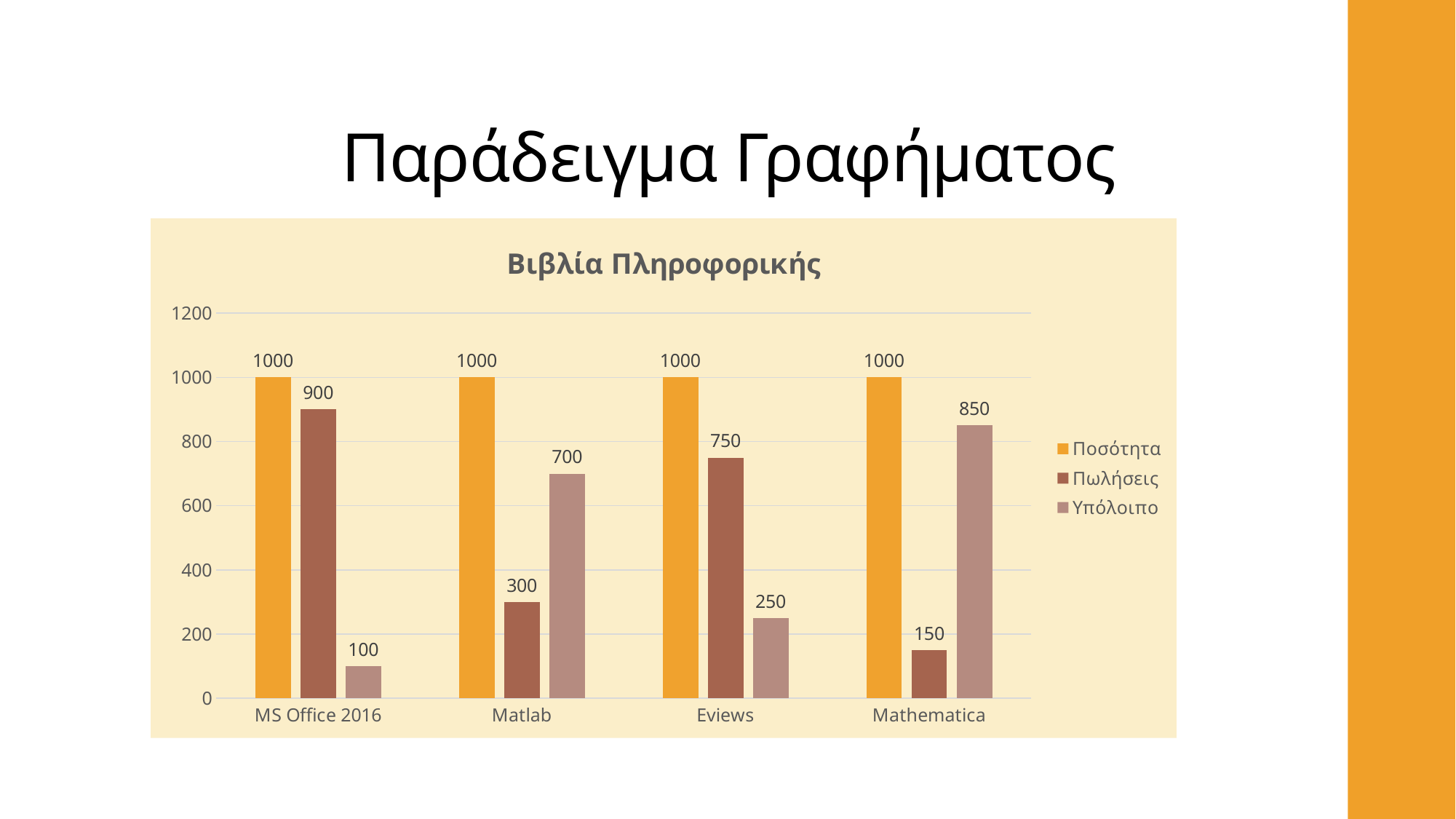
What is the Πωλήσεις value for MS Office 2016? 900 What is the Πωλήσεις value for Eviews? 750 Which is larger: the Πωλήσεις value for Matlab or the Πωλήσεις value for Mathematica? Matlab What is the Υπόλοιπο value for Matlab? 700 What is the title of the chart? Βιβλία Πληροφορικής What is the difference between the Υπόλοιπο values for Mathematica and Eviews? 600 What kind of chart is shown? Bar chart How many series does the legend list? 3 How many categories are shown on the x axis? 4 Which category has the highest Πωλήσεις value? MS Office 2016 Which category has the lowest Υπόλοιπο value? MS Office 2016 What is the Ποσότητα value for Mathematica? 1000